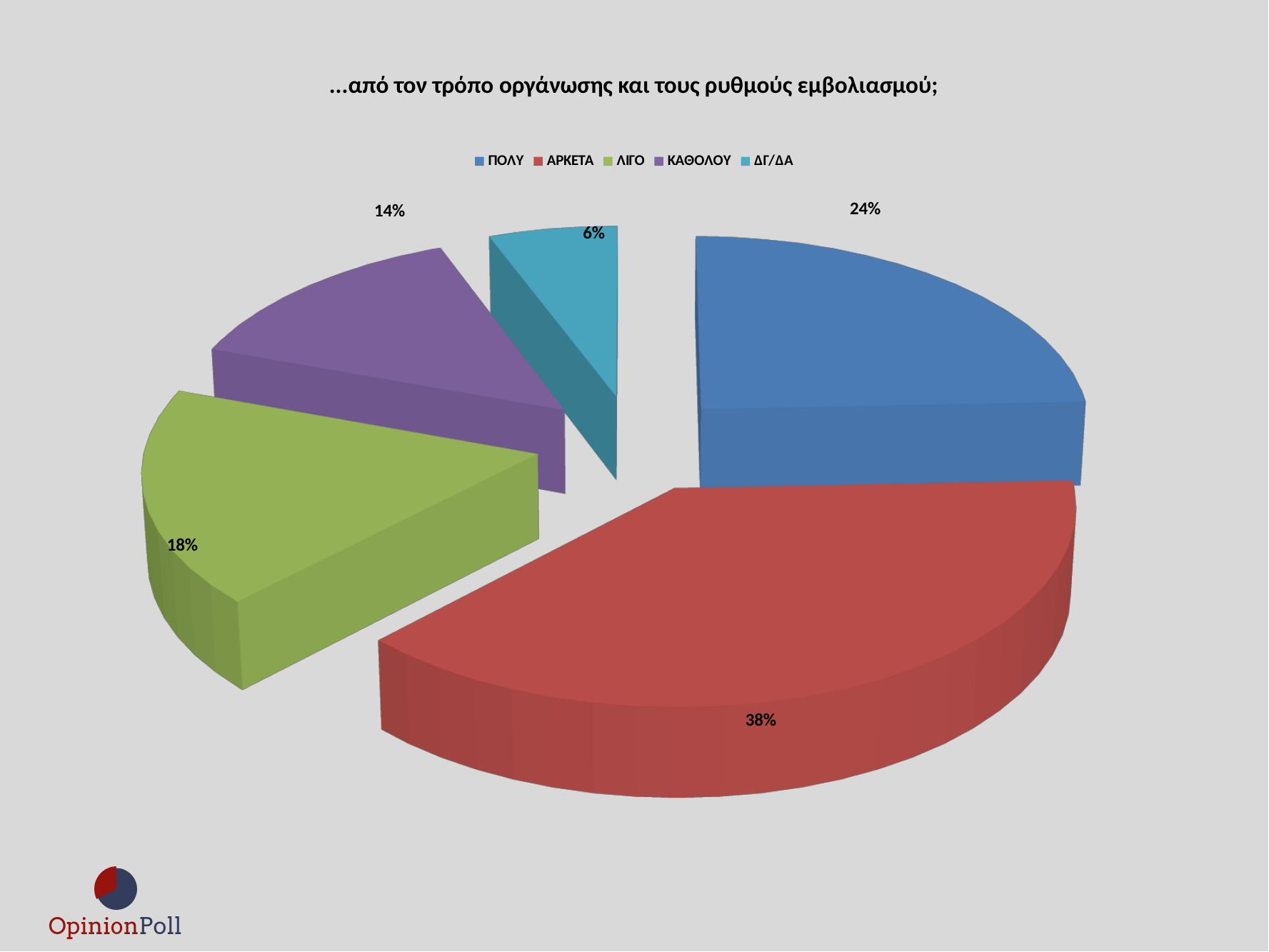
What percentage is shown for ΠΟΛΥ? 24% What is the difference in percentage points between ΑΡΚΕΤΑ and ΠΟΛΥ? 14 What type of chart is shown on the slide? Pie chart Which category has the largest share of the pie? ΑΡΚΕΤΑ What colour is the slice for ΠΟΛΥ? Blue How many categories does the legend list? 5 What percentage is shown for ΛΙΓΟ? 18% What percentage is shown for ΑΡΚΕΤΑ? 38% Which is larger, the share for ΛΙΓΟ or the share for ΚΑΘΟΛΟΥ? ΛΙΓΟ What percentage is shown for ΔΓ/ΔΑ? 6% What percentage is shown for ΚΑΘΟΛΟΥ? 14% Which category has the smallest share of the pie? ΔΓ/ΔΑ